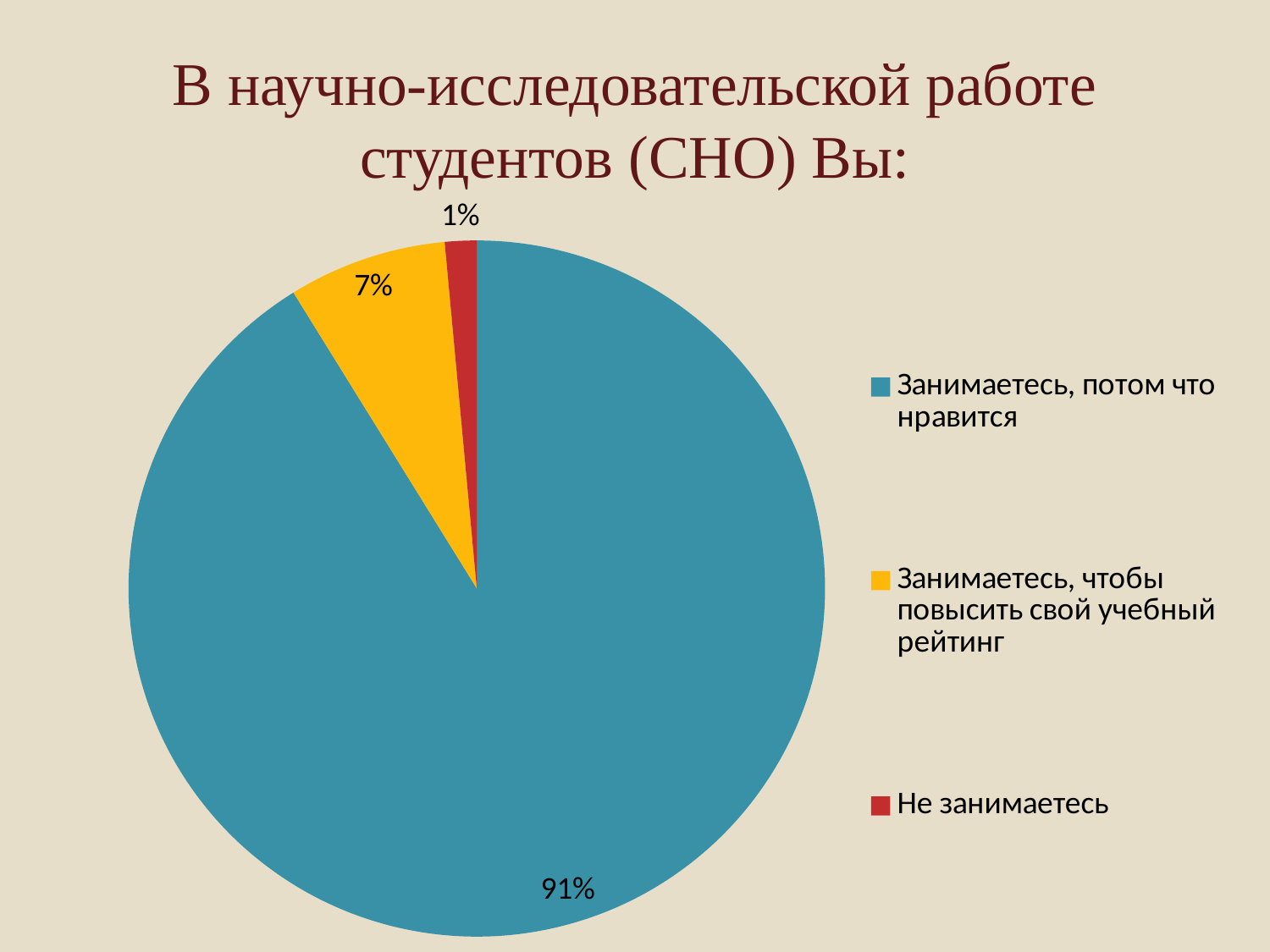
What is the title of the slide above the pie chart? В научно-исследовательской работе студентов (СНО) Вы: How many categories does the pie chart have? 3 What share of the pie is labelled "Занимаетесь, потом что нравится"? 91% What is the difference in percentage points between the "Занимаетесь, потом что нравится" slice and the "Занимаетесь, чтобы повысить свой учебный рейтинг" slice? 84 Which category has the largest slice of the pie? Занимаетесь, потом что нравится Which is larger: the "Занимаетесь, чтобы повысить свой учебный рейтинг" slice or the "Не занимаетесь" slice? Занимаетесь, чтобы повысить свой учебный рейтинг What share of the pie is labelled "Не занимаетесь"? 1% What is the difference in percentage points between the "Занимаетесь, чтобы повысить свой учебный рейтинг" slice and the "Не занимаетесь" slice? 6 What colour is the slice for "Не занимаетесь"? Red What kind of chart is shown on the slide? Pie chart What share of the pie is labelled "Занимаетесь, чтобы повысить свой учебный рейтинг"? 7% Which category has the smallest slice of the pie? Не занимаетесь